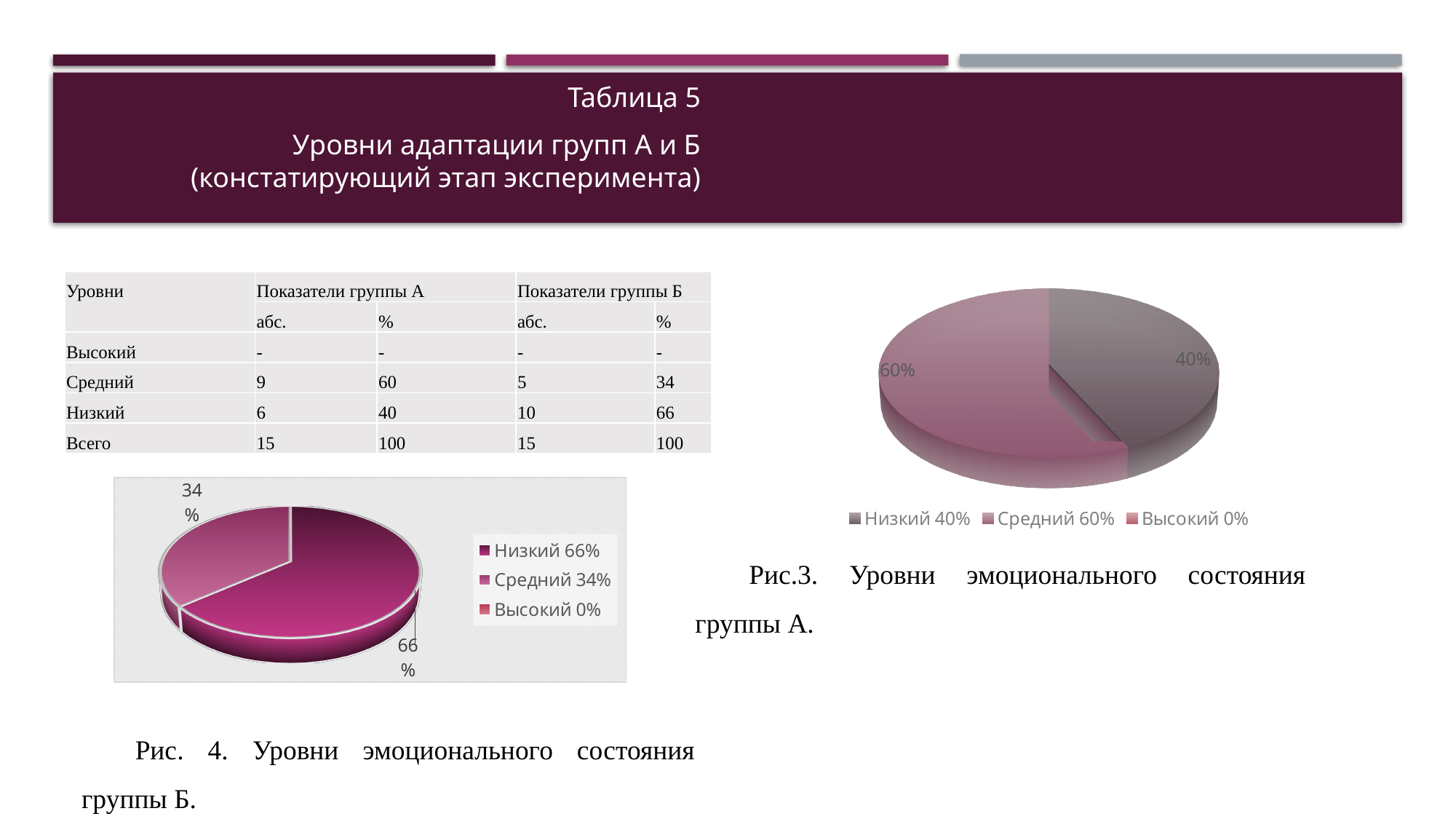
In the pie chart for group A (Рис. 3, right side of the slide), what share does the Низкий slice have? 40% What type of chart is used for Рис. 4 (lower left of the slide)? Pie chart In the pie chart for group Б (Рис. 4, lower left of the slide), what is the difference between the Низкий and Средний shares? 32% In the pie chart for group A (Рис. 3, right side of the slide), which level has the largest share? Средний In the pie chart for group Б (Рис. 4, lower left of the slide), which level has the largest share? Низкий In the pie chart for group Б (Рис. 4, lower left of the slide), what share does the Низкий slice have? 66% In the pie chart for group A (Рис. 3, right side of the slide), what share does the Средний slice have? 60% In the pie chart for group A (Рис. 3, right side of the slide), what is the difference between the Средний and Низкий shares? 20% Which is larger: the Низкий share in the group A chart (Рис. 3) or the Низкий share in the group Б chart (Рис. 4)? Group Б (Рис. 4) In the pie chart for group Б (Рис. 4, lower left of the slide), what share does the legend give for Высокий? 0% How many entries does the legend of the pie chart for group A (Рис. 3, right side of the slide) list? 3 In the pie chart for group Б (Рис. 4, lower left of the slide), what share does the Средний slice have? 34%